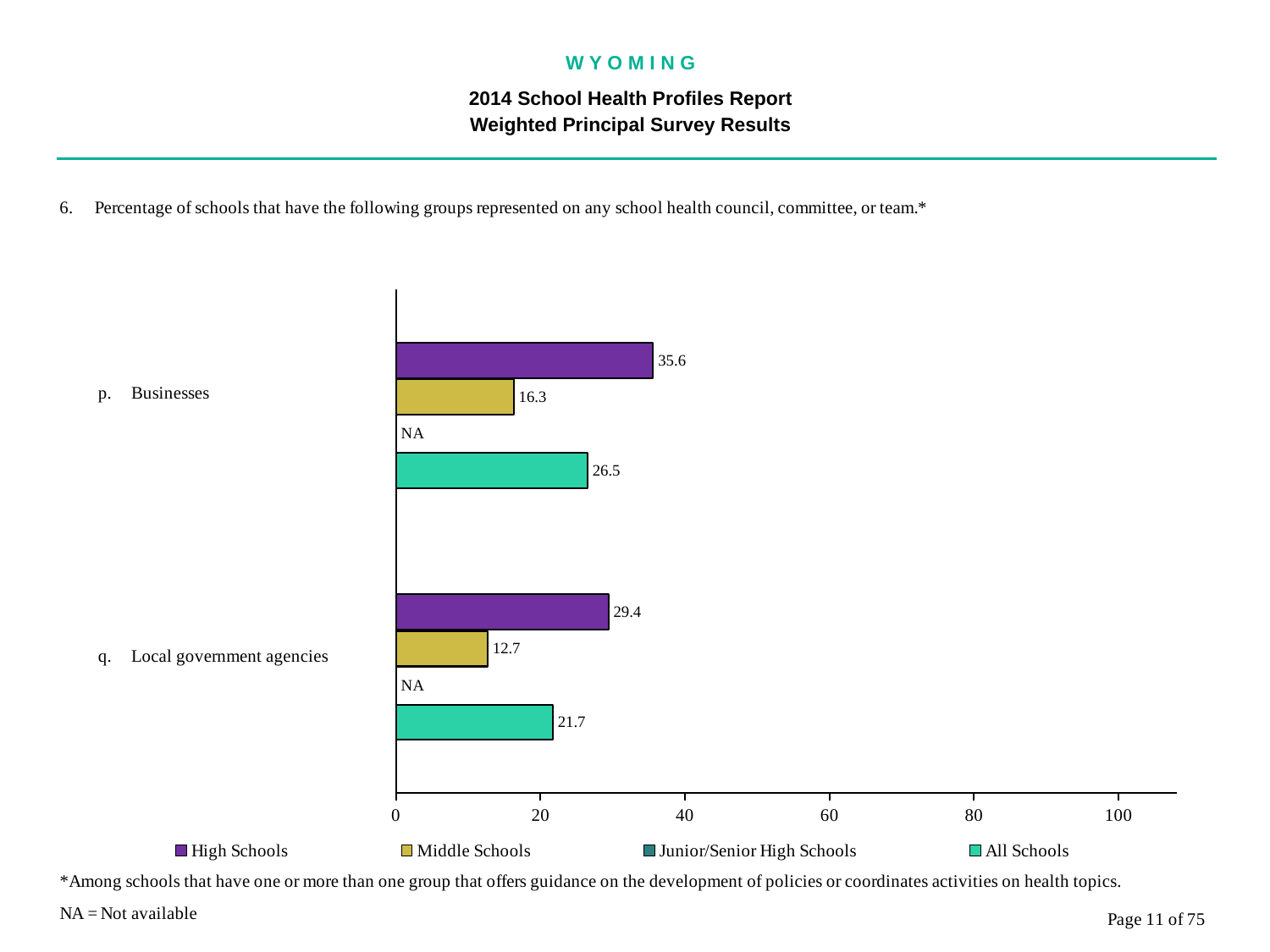
What is the value for All Schools for Businesses? 26.5 Which series has the lowest printed value for Businesses? Middle Schools Which is larger: the All Schools value for Businesses or for Local government agencies? Businesses Is the High Schools value for Local government agencies greater or less than 20? greater What is the value for High Schools for Businesses? 35.6 What is the difference between the High Schools values for Businesses and Local government agencies? 6.2 What kind of chart is this? bar chart What is the value for Middle Schools for Local government agencies? 12.7 What is shown for Junior/Senior High Schools for Local government agencies? NA Which series has the highest value for Local government agencies? High Schools How many series does the legend list? 4 How many categories are shown on the chart? 2